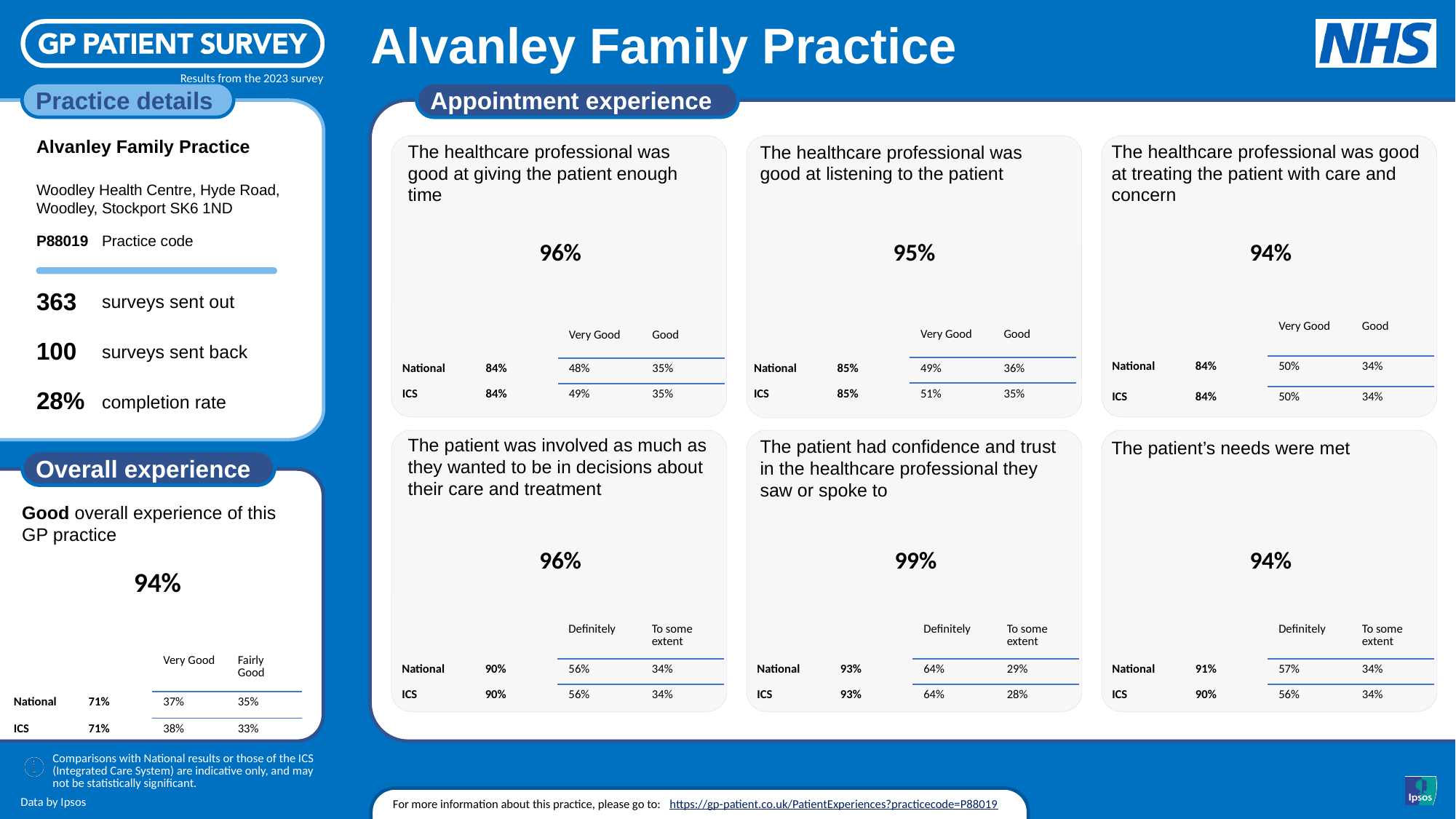
Among the six Appointment experience panels, which measure has the highest practice percentage? The patient had confidence and trust in the healthcare professional they saw or spoke to (99%) In the 'Overall experience' panel, what percentage of patients reported a Good overall experience of this GP practice? 94% In the 'The patient had confidence and trust in the healthcare professional they saw or spoke to' panel, what is the ICS 'To some extent' percentage? 28% In the 'The healthcare professional was good at listening to the patient' panel, which is larger: the practice's percentage or the National percentage? The practice's percentage (95%) What are the two column headings in the comparison table of the 'The patient's needs were met' panel? Definitely, To some extent How many measures are shown in the Appointment experience section? 6 In the 'The patient had confidence and trust in the healthcare professional they saw or spoke to' panel, what is the practice's percentage? 99% Among the three panels in the top row of the Appointment experience section, which measure has the lowest practice percentage? The healthcare professional was good at treating the patient with care and concern (94%) In the 'The patient's needs were met' panel, what is the ICS overall percentage? 90% In the 'The healthcare professional was good at giving the patient enough time' panel, what is the difference between the practice's percentage and the National percentage? 12 percentage points In the 'The healthcare professional was good at listening to the patient' panel, what is the National 'Very Good' percentage? 49% In the 'Overall experience' panel, what is the difference between the practice's percentage and the National percentage? 23 percentage points